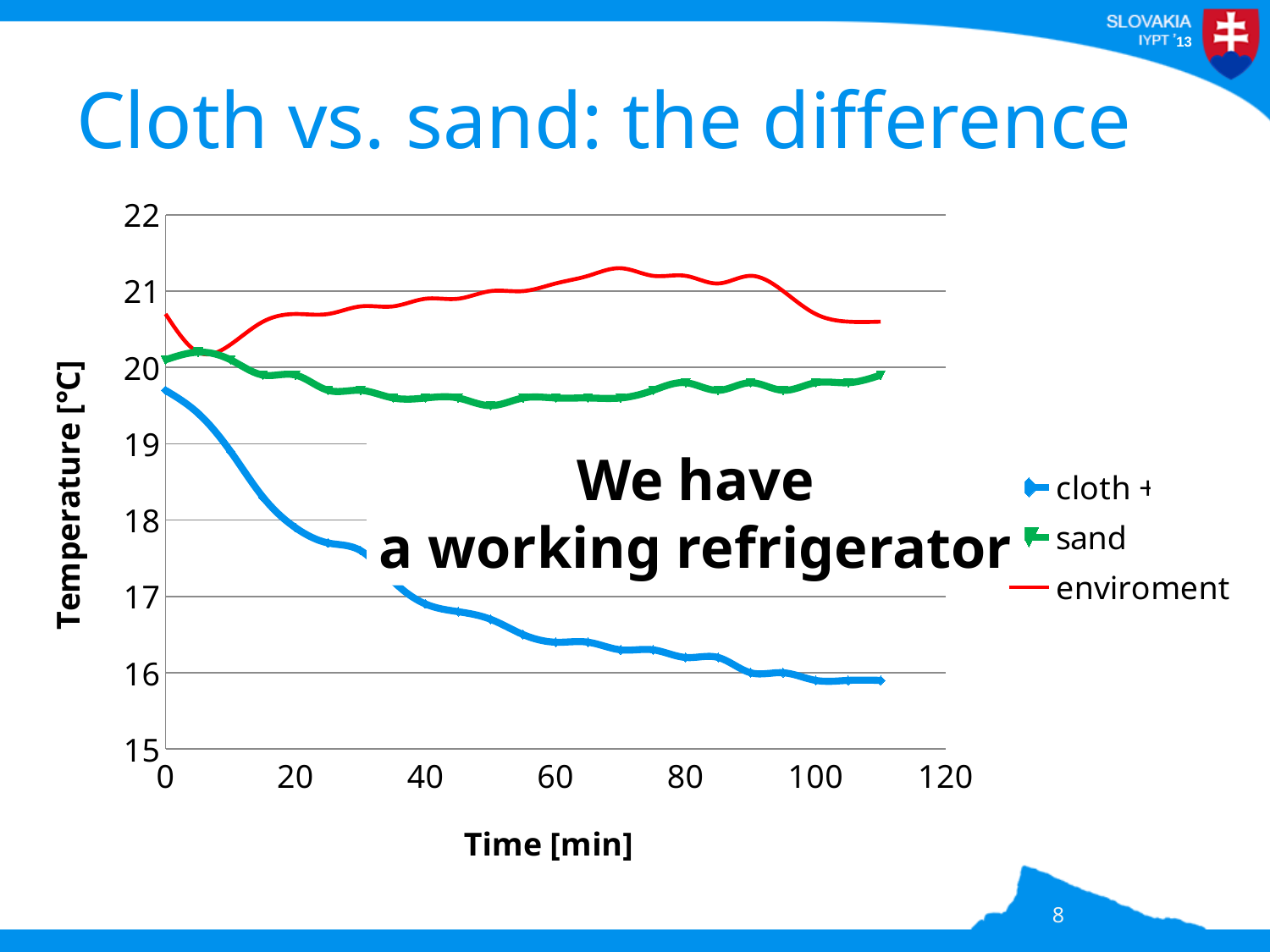
What is the label of the vertical axis? Temperature [°C] How many series does the legend list? 3 Does the temperature of the 'cloth +' series rise or fall as time increases? fall Is the value for 'enviroment' at 70 min greater or less than 21? greater What kind of chart is shown on the slide? line chart At 60 min, which series has the higher temperature, 'sand' or 'cloth +'? sand Which series has the highest temperature at 80 min? enviroment Is the value for 'enviroment' at 0 min greater or less than 20? greater Is the value for 'cloth +' at 60 min greater or less than 17? less Which series has the lowest temperature at 110 min? cloth + What colour is the 'sand' series drawn in? green